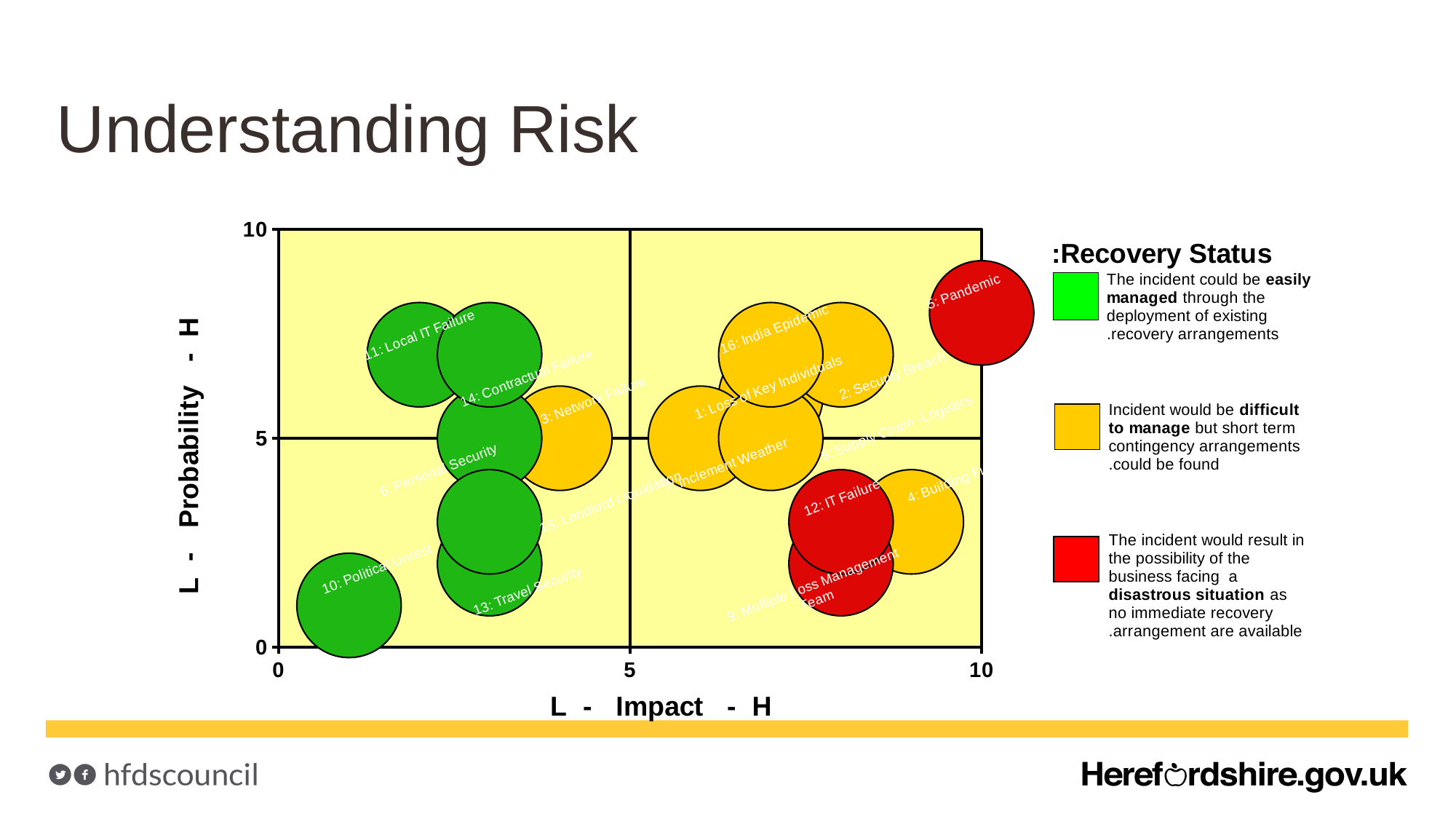
What is the label of the x axis of the chart? L - Impact - H Which has the higher probability, 11: Local IT Failure or 13: Travel Security? 11: Local IT Failure Is the impact for 10: Political Unrest greater or less than 5? less What is the label of the y axis of the chart? L - Probability - H Is the probability for 12: IT Failure greater or less than 5? less What kind of chart is shown on the slide? Bubble chart Is the probability for 5: Pandemic greater or less than 5? greater How many red bubbles are plotted on the chart? 3 How many recovery status categories does the legend list? 3 Which risk has the lowest impact on the chart? 10: Political Unrest Which risk has the highest probability on the chart? 5: Pandemic